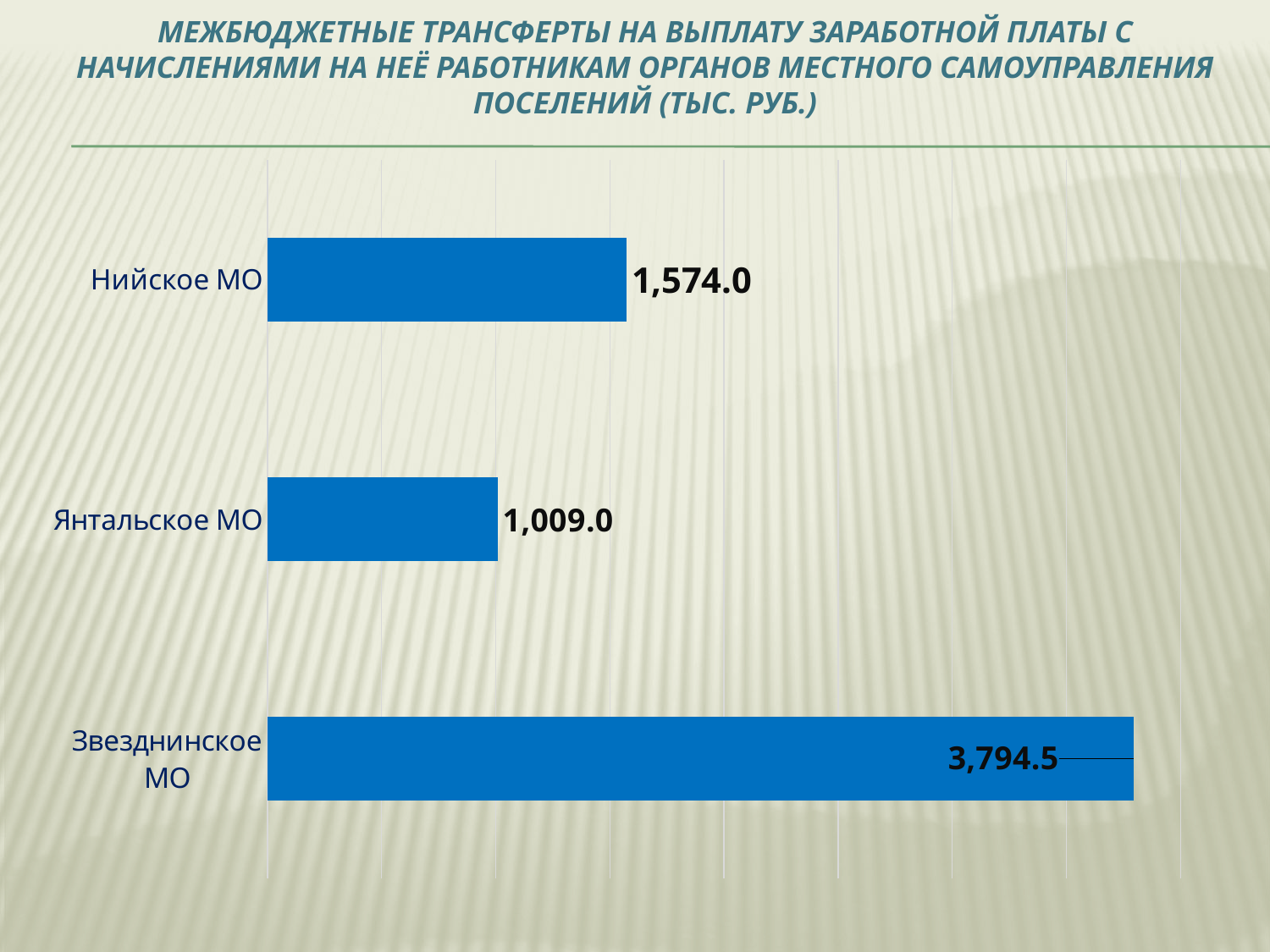
What is the value for Звезднинское МО? 3,794.5 What is the value for Янтальское МО? 1,009.0 Which category has the highest value? Звезднинское МО What unit is given in the chart title? тыс. руб. Which is larger, the value for Нийское МО or the value for Янтальское МО? Нийское МО What is the value for Нийское МО? 1,574.0 What is the total of the three values shown in the chart? 6,377.5 What is the difference between the values for Звезднинское МО and Нийское МО? 2,220.5 What kind of chart is shown on the slide? Bar chart Which category has the lowest value? Янтальское МО What is the difference between the values for Нийское МО and Янтальское МО? 565.0 How many categories are shown in the chart? 3